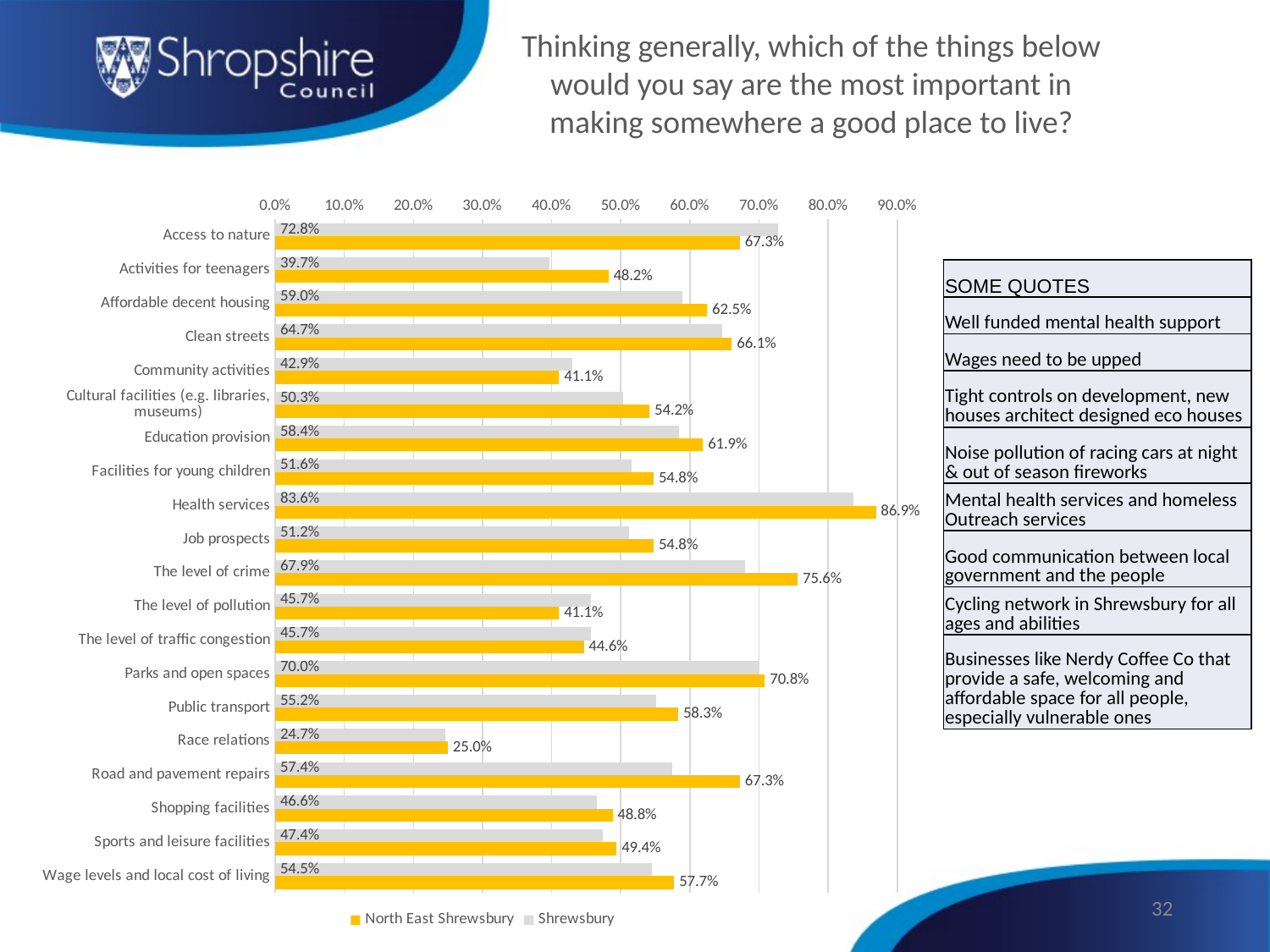
How many series does the legend list? 2 What is the North East Shrewsbury value for Road and pavement repairs? 67.3% Which colour represents the North East Shrewsbury series? Yellow Which category has the highest North East Shrewsbury value? Health services What kind of chart is shown on the slide? Bar chart For Activities for teenagers, which is larger: the North East Shrewsbury value or the Shrewsbury value? North East Shrewsbury Is the Shrewsbury value for Parks and open spaces greater or less than 60.0%? greater What is the Shrewsbury value for Access to nature? 72.8% Which category has the lowest Shrewsbury value? Race relations How many categories are shown on the chart? 20 What is the difference between the North East Shrewsbury and Shrewsbury values for The level of crime? 7.7% What is the North East Shrewsbury value for Health services? 86.9%